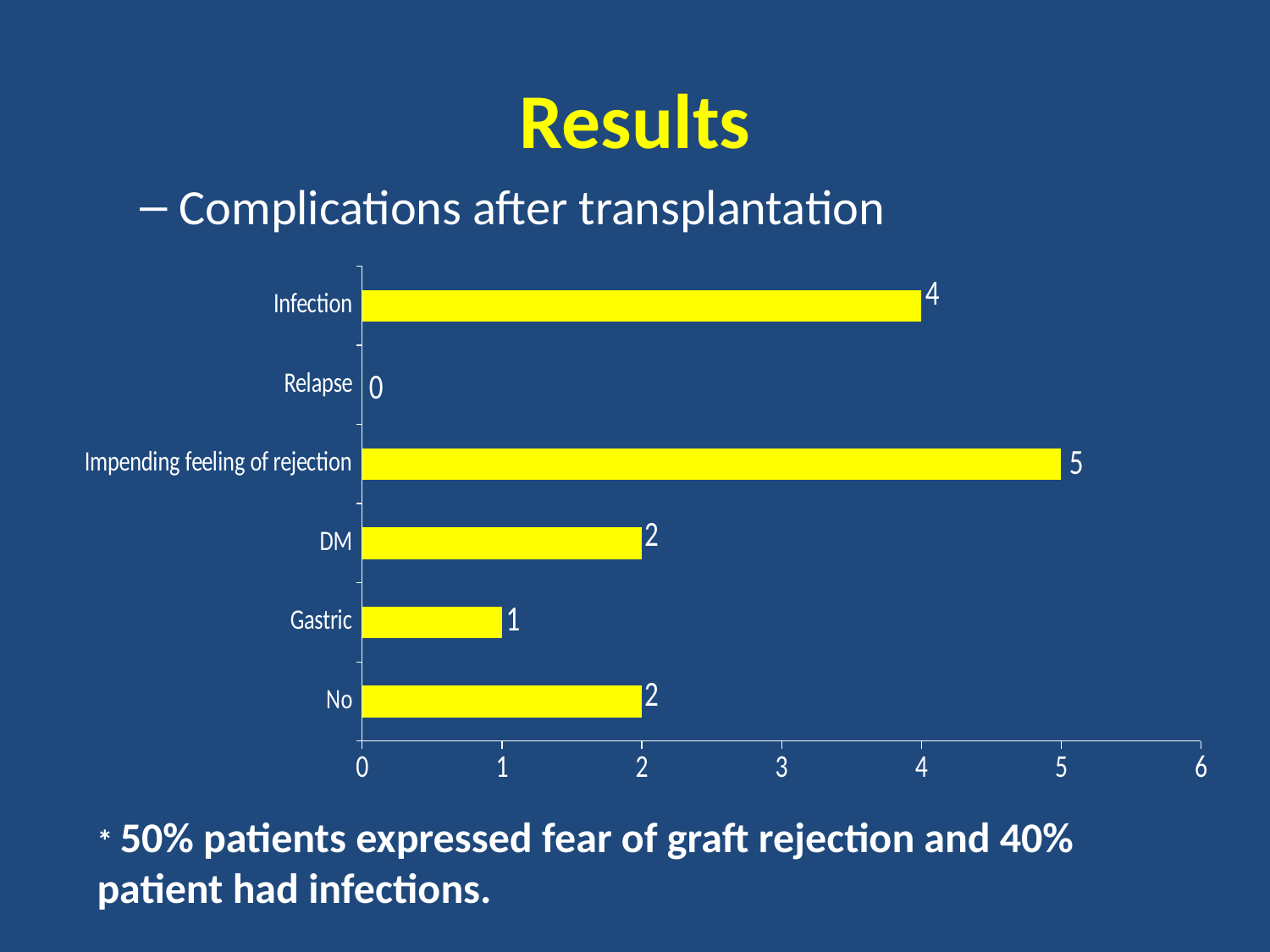
What is the value for Relapse? 0 Which category has the highest value? Impending feeling of rejection What is the value for Gastric? 1 Which is larger, the value for DM or the value for Gastric? DM What is the difference between the values for Impending feeling of rejection and Infection? 1 What is the value for Impending feeling of rejection? 5 What is the value for Infection? 4 What kind of chart is shown on the slide? bar chart Which category has the lowest value? Relapse What colour are the bars in the chart? yellow How many categories are shown in the chart? 6 Is the value for Infection greater or less than 3? greater